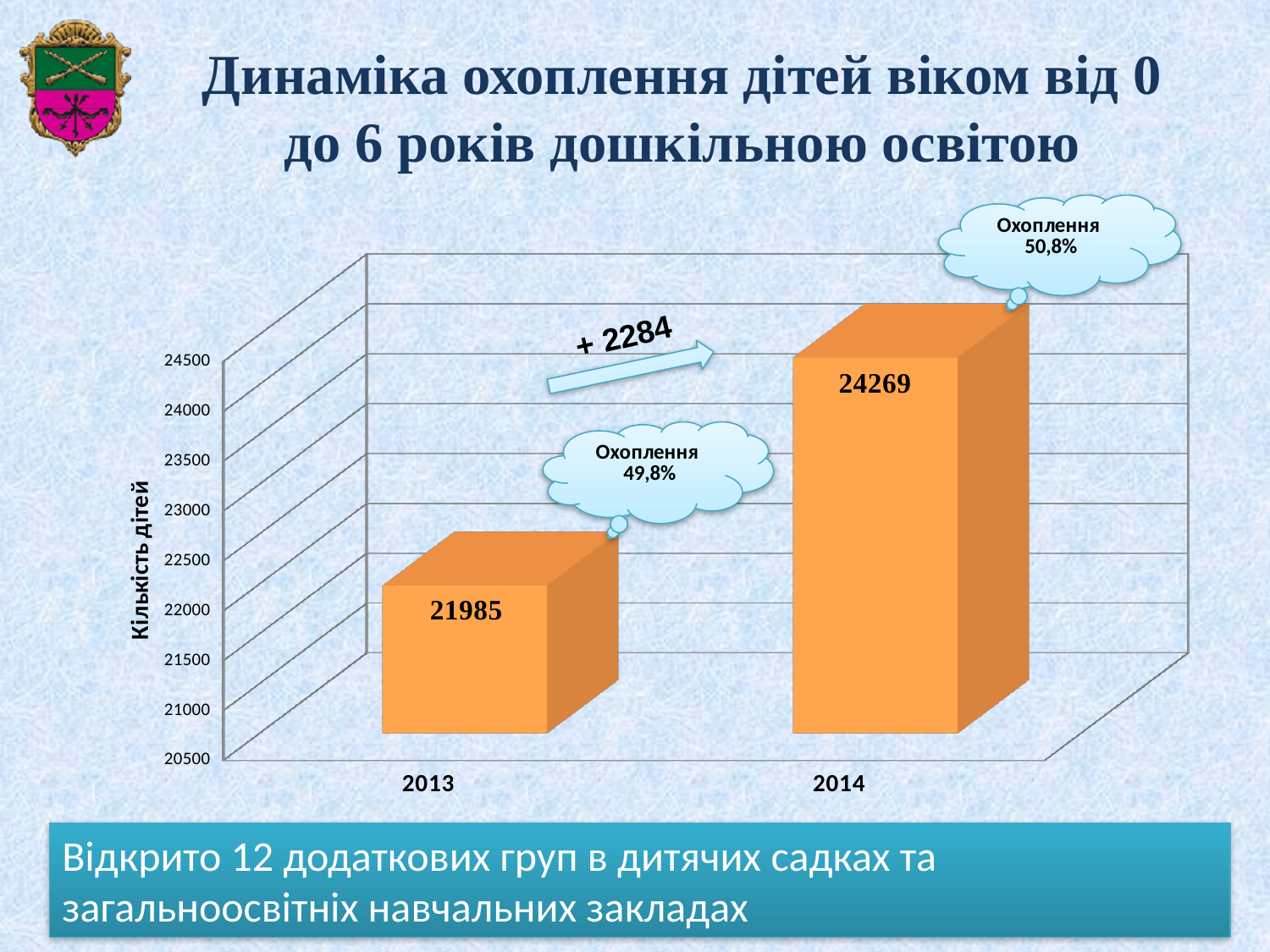
Do the values rise or fall from 2013 to 2014? rise Which year has the lower value? 2013 Is the value for 2013 larger or smaller than the value for 2014? smaller What is the difference between the values for 2014 and 2013? 2284 How many categories are shown on the x axis? 2 What is the value for 2013? 21985 What is the label of the vertical axis? Кількість дітей Which year has the higher value? 2014 Is the value for 2013 greater or less than 22500? less What kind of chart is shown on the slide? bar chart What is the value for 2014? 24269 Is the value for 2014 greater or less than 24000? greater